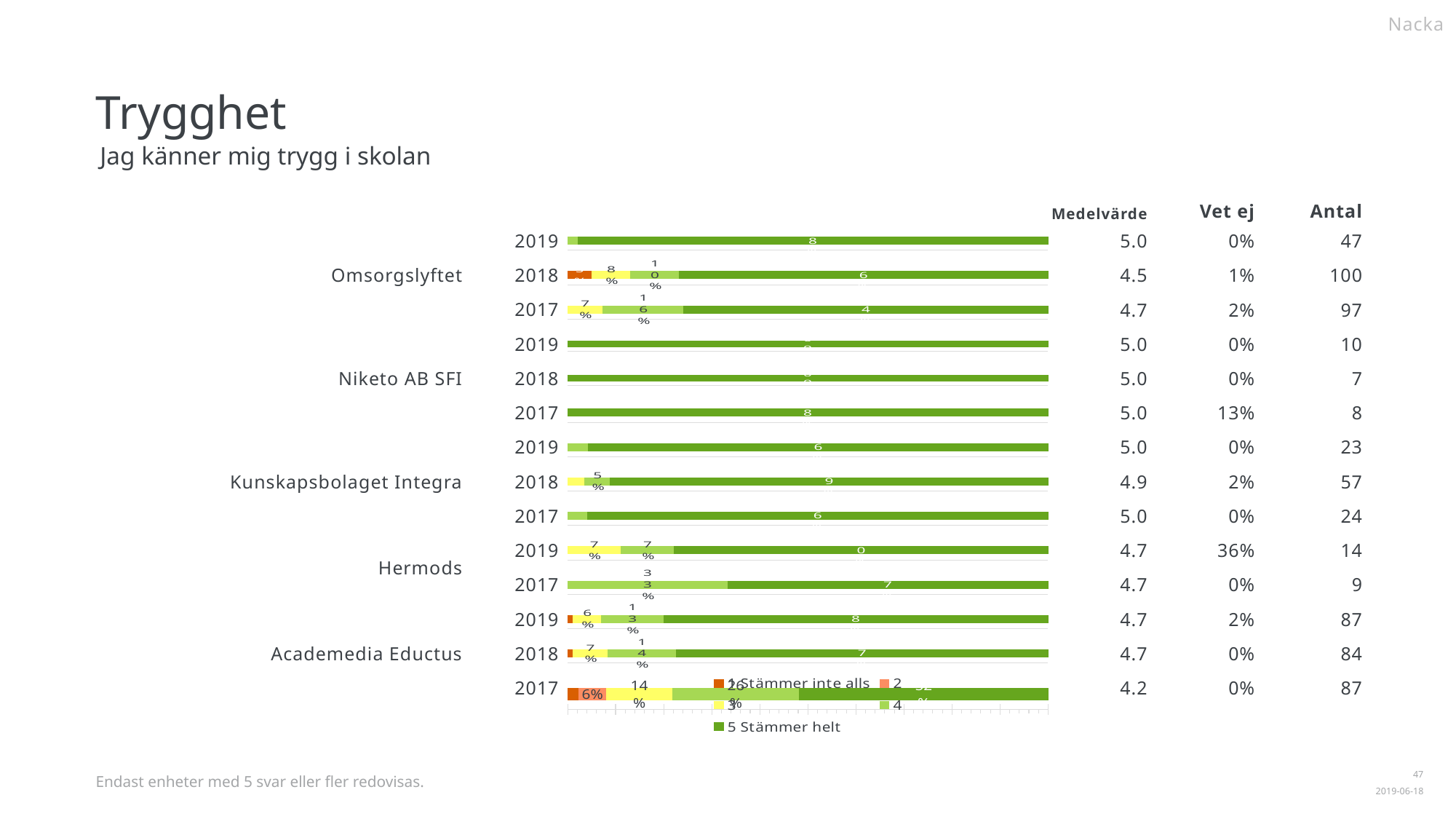
What is the Vet ej share for Hermods in 2019? 36% What is the Antal for Omsorgslyftet in 2018? 100 How many series does the legend list? 5 Which has a higher Antal, Kunskapsbolaget Integra 2018 or Academedia Eductus 2019? Academedia Eductus 2019 What is the Medelvärde for Academedia Eductus in 2017? 4.2 What kind of chart is shown on the slide? stacked bar chart How many bars (unit-year rows) are plotted in the chart? 14 What is the difference in Antal between Omsorgslyftet 2018 and Omsorgslyftet 2017? 3 What is the Vet ej share for Niketo AB SFI in 2017? 13% What is the label of the first legend entry? 1 Stämmer inte alls What is the Medelvärde for Omsorgslyftet in 2018? 4.5 Which unit-year row has the lowest Medelvärde? Academedia Eductus 2017